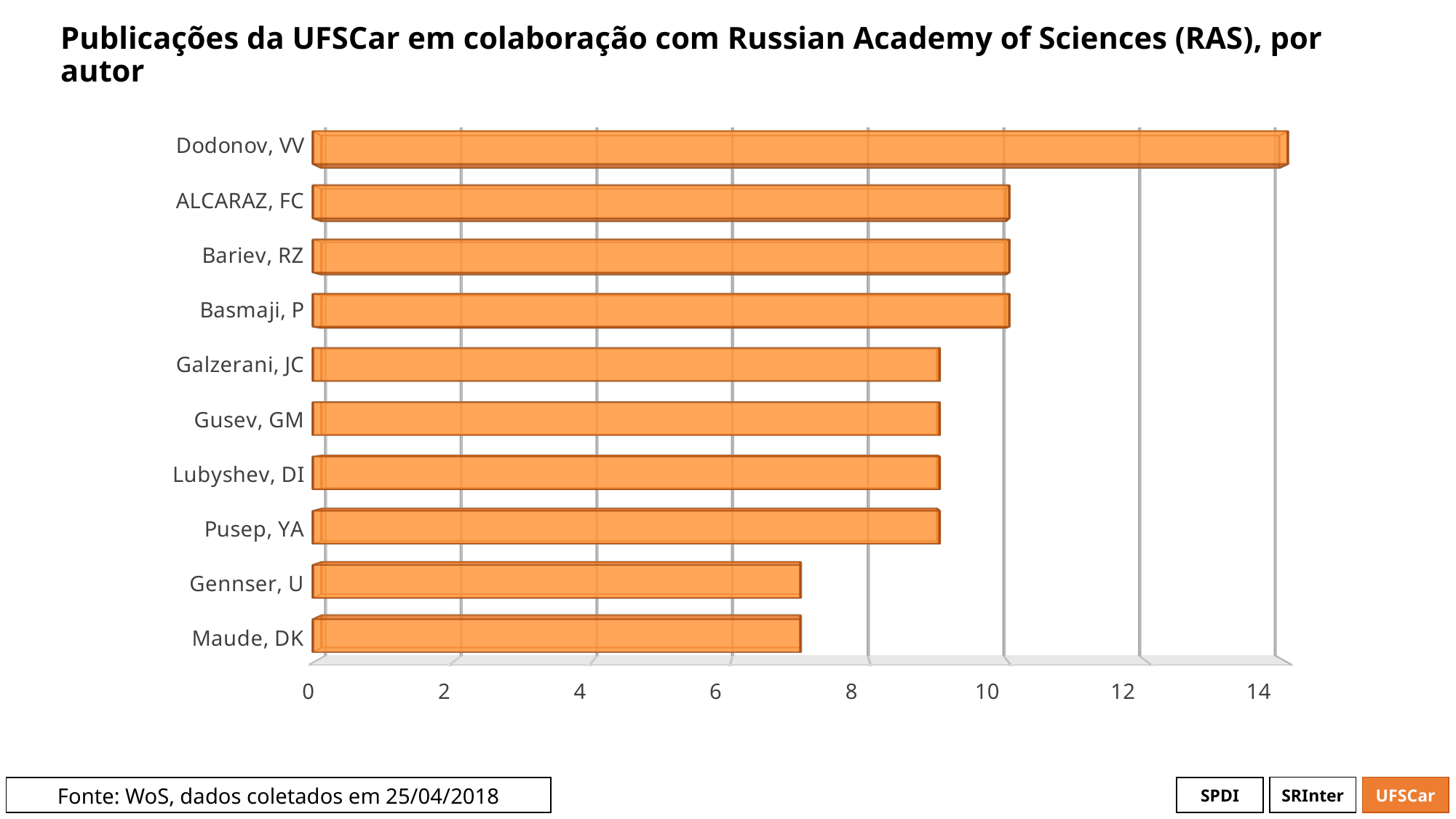
Which is larger, the value for Gennser, U or the value for Lubyshev, DI? Lubyshev, DI Is the value for Gennser, U greater or less than 8? less Is the value for Dodonov, VV greater or less than 12? greater Which is larger, the value for Basmaji, P or the value for Pusep, YA? Basmaji, P Which is larger, the value for Dodonov, VV or the value for ALCARAZ, FC? Dodonov, VV Is the value for Maude, DK greater or less than 6? greater What kind of chart is shown on the slide? bar chart How many authors are listed on the chart? 10 What is the title of the chart? Publicações da UFSCar em colaboração com Russian Academy of Sciences (RAS), por autor Which author has the highest number of publications? Dodonov, VV